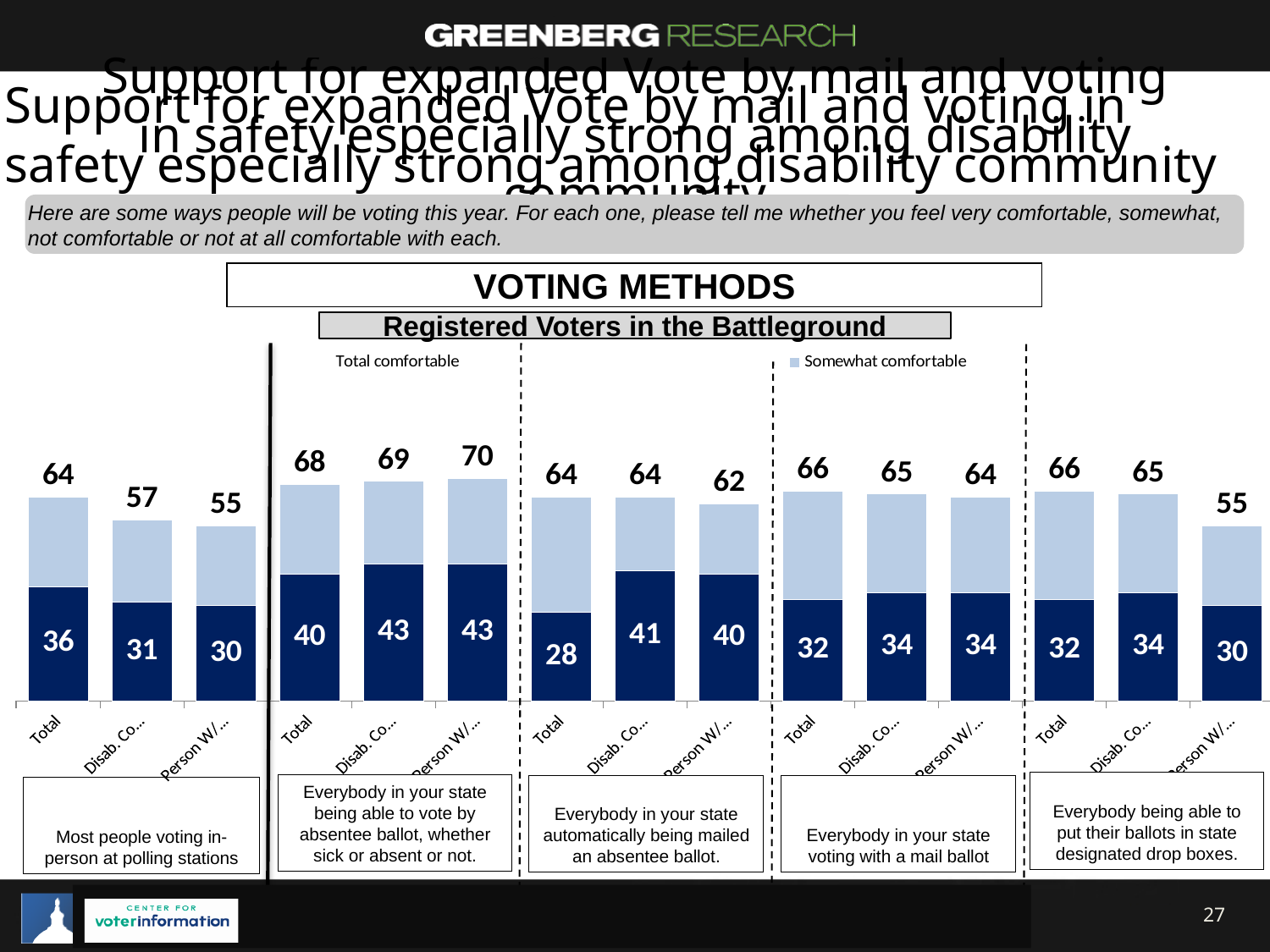
In the chart for "Most people voting in-person at polling stations", what is the total comfortable value for the Total category? 64 What is the difference between the Total category's total comfortable value in the absentee ballot chart (68) and in the in-person polling stations chart (64)? 4 In the chart for "Everybody in your state being able to vote by absentee ballot, whether sick or absent or not", what is the total comfortable value for the third (rightmost) bar? 70 In the chart for "Everybody in your state being able to vote by absentee ballot, whether sick or absent or not", do the total comfortable values rise or fall from left to right? Rise In the chart for "Everybody in your state being able to vote by absentee ballot, whether sick or absent or not", which category has the lowest total comfortable value? Total In the chart for "Most people voting in-person at polling stations", what is the difference between the total comfortable value of the Total bar and the third (rightmost) bar? 9 In the chart for "Everybody being able to put their ballots in state designated drop boxes", which has the larger total comfortable value: the Total bar or the third (rightmost) bar? Total In the chart for "Everybody in your state voting with a mail ballot", what is the total comfortable value for the Total category? 66 In the chart for "Most people voting in-person at polling stations", which category has the highest total comfortable value? Total What kind of chart is used to show the voting methods data on this slide? Bar chart In the chart for "Everybody in your state automatically being mailed an absentee ballot", what value is printed in the dark segment of the Total bar? 28 How many bars are shown in the chart for "Everybody in your state voting with a mail ballot"? 3